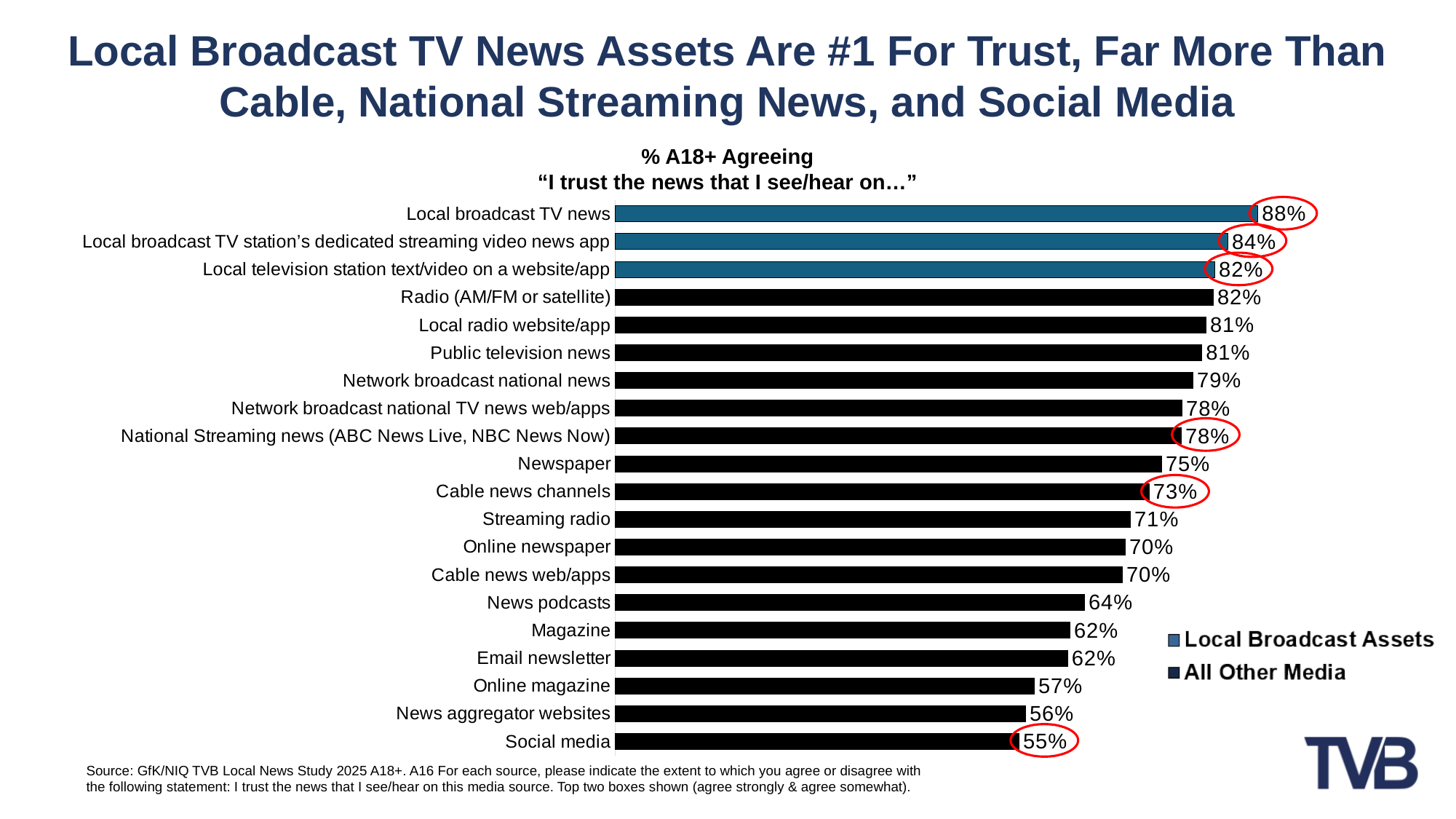
What kind of chart is shown on the slide? Bar chart Which media source has the lowest trust percentage on the chart? Social media What is the value shown for National Streaming news (ABC News Live, NBC News Now)? 78% How many media sources (categories) are plotted on the chart? 20 Which media source has the highest trust percentage on the chart? Local broadcast TV news What percentage of A18+ agree they trust the news they see/hear on Local broadcast TV news? 88% Which has a higher trust percentage: Newspaper or Online newspaper? Newspaper What is the difference in percentage points between Local broadcast TV news and Cable news channels? 15 How many series does the legend list? 2 What is the difference in percentage points between Local broadcast TV news and Social media? 33 Which legend entry is represented by the blue bars? Local Broadcast Assets What is the value shown for Cable news channels? 73%